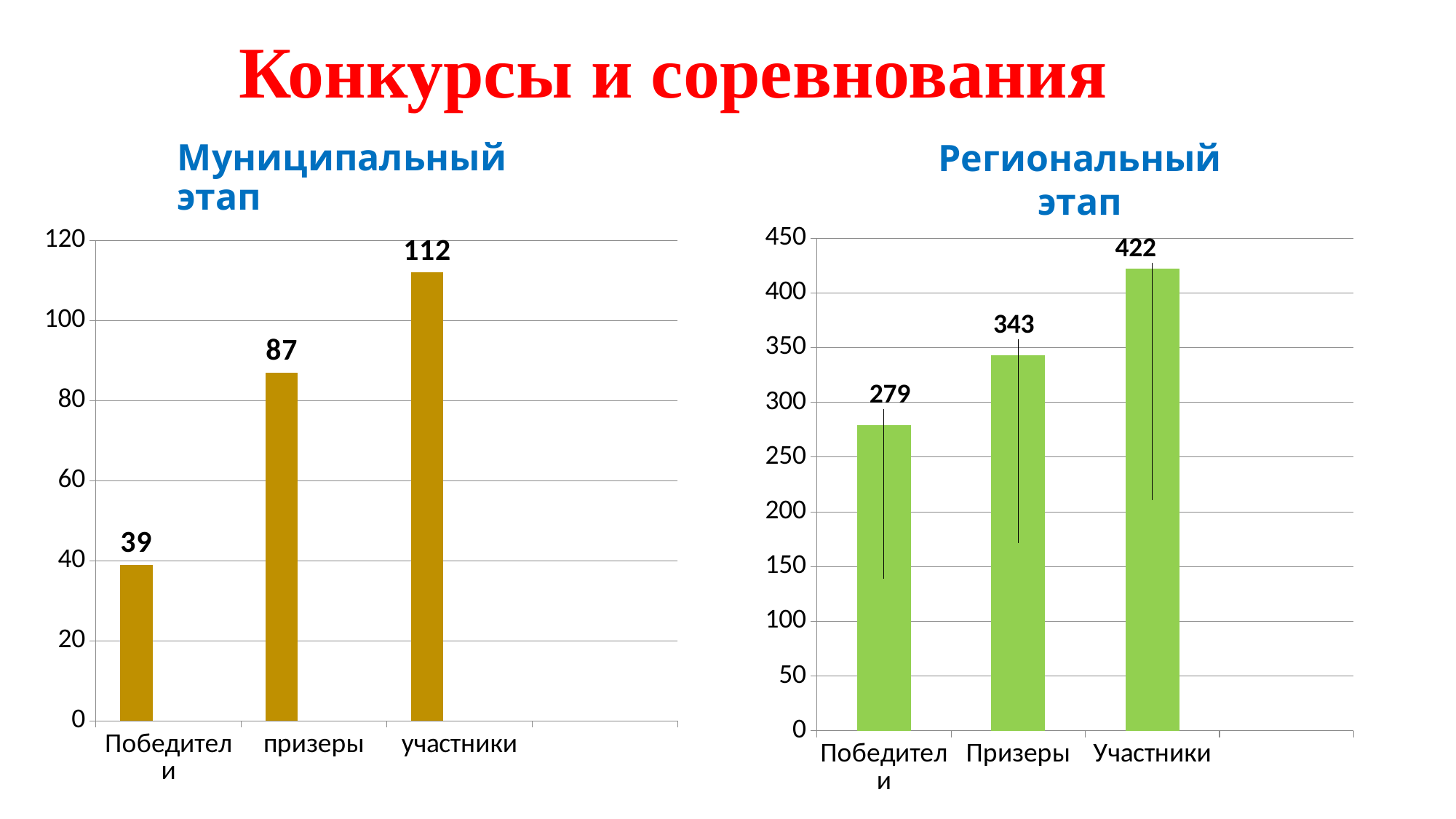
What kind of chart is the 'Региональный этап' chart? bar chart How many categories are shown in the 'Муниципальный этап' chart? 3 In the 'Муниципальный этап' chart, do the values rise or fall from left to right? rise In the 'Региональный этап' chart, what is the value for Призеры? 343 In the 'Муниципальный этап' chart, what is the value for призеры? 87 In the 'Региональный этап' chart, what is the difference between Участники and Призеры? 79 In the 'Муниципальный этап' chart, which category has the highest value? участники In the 'Региональный этап' chart, which category has the lowest value? Победители In the 'Муниципальный этап' chart, what is the value for Победители? 39 In the 'Муниципальный этап' chart, what is the difference between участники and Победители? 73 In the 'Региональный этап' chart, what is the value for Участники? 422 In the 'Региональный этап' chart, which is larger: Победители or Призеры? Призеры